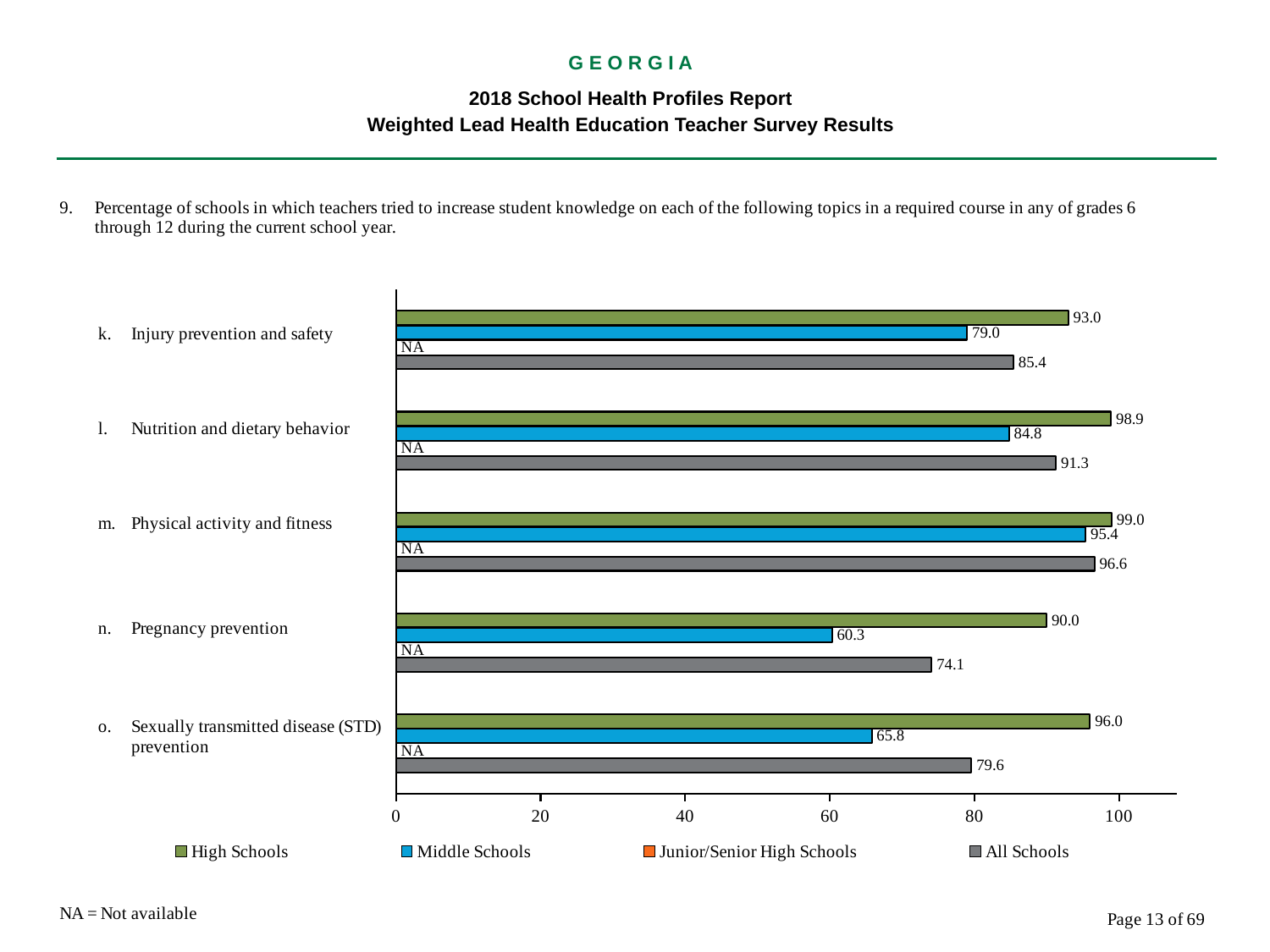
Which is larger: the All Schools value for Nutrition and dietary behavior or the All Schools value for Injury prevention and safety? Nutrition and dietary behavior Which topic has the highest All Schools value? Physical activity and fitness What kind of chart is shown on the slide? bar chart Which topic has the lowest Middle Schools value? Pregnancy prevention What value is shown for Junior/Senior High Schools for Pregnancy prevention? NA How many series does the legend list? 4 What is the Middle Schools value for Pregnancy prevention? 60.3 What does NA stand for according to the slide? Not available What is the difference between the High Schools and Middle Schools values for Injury prevention and safety? 14.0 How many topics are shown on the chart? 5 What is the All Schools value for Sexually transmitted disease (STD) prevention? 79.6 What is the High Schools value for Physical activity and fitness? 99.0